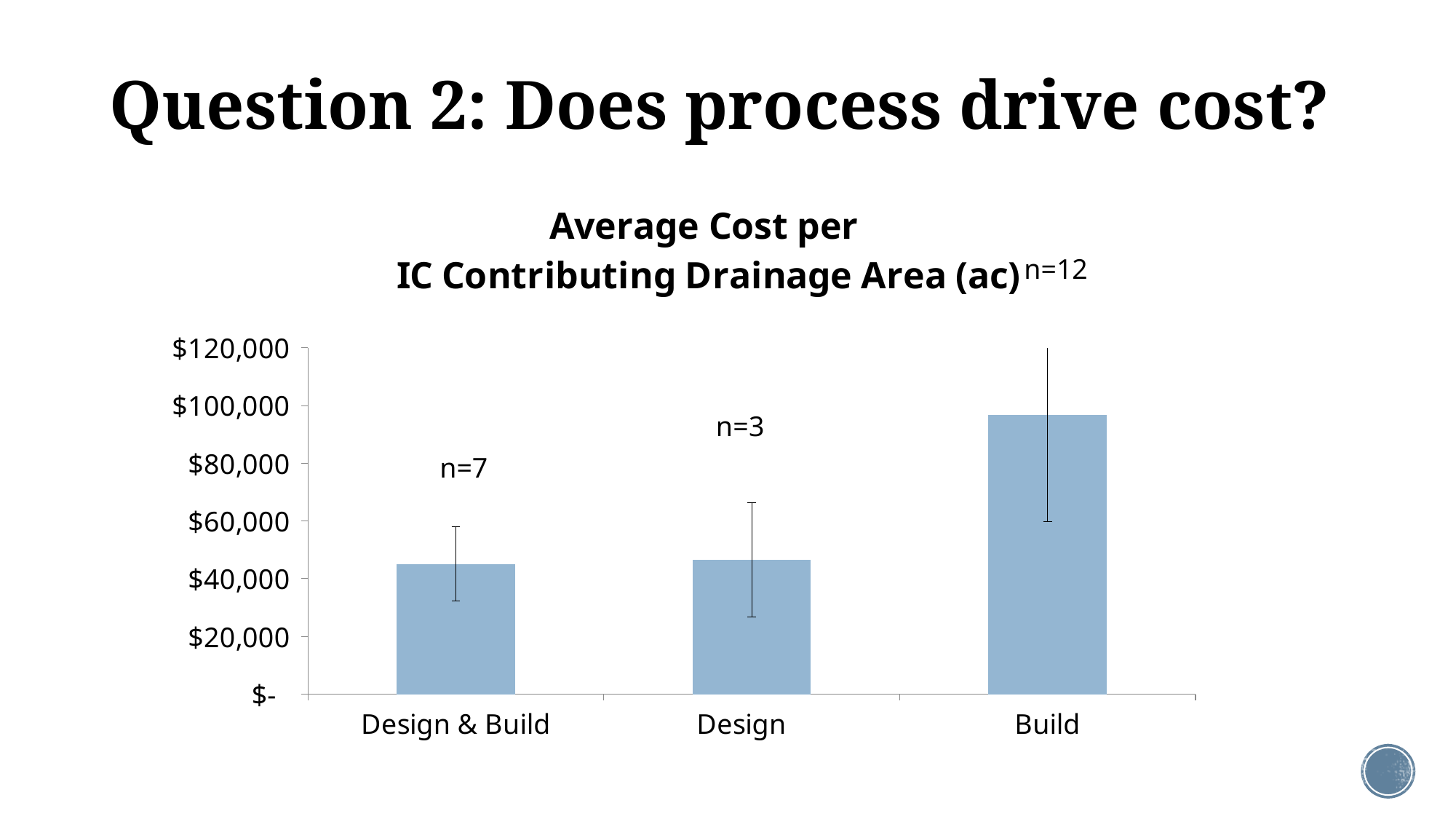
Which category has the highest average cost per IC contributing drainage area? Build Which is larger, the value for Build or the value for Design & Build? Build Which is larger, the value for Design or the value for Build? Build Is the value for Design greater or less than $20,000? greater What kind of chart is shown on the slide? bar chart What is the title of the chart? Average Cost per IC Contributing Drainage Area (ac) Is the value for Design greater or less than $60,000? less Is the value for Design & Build greater or less than $60,000? less How many categories are plotted on the x axis of the chart? 3 What sample size (n) is printed above the Design & Build bar? n=7